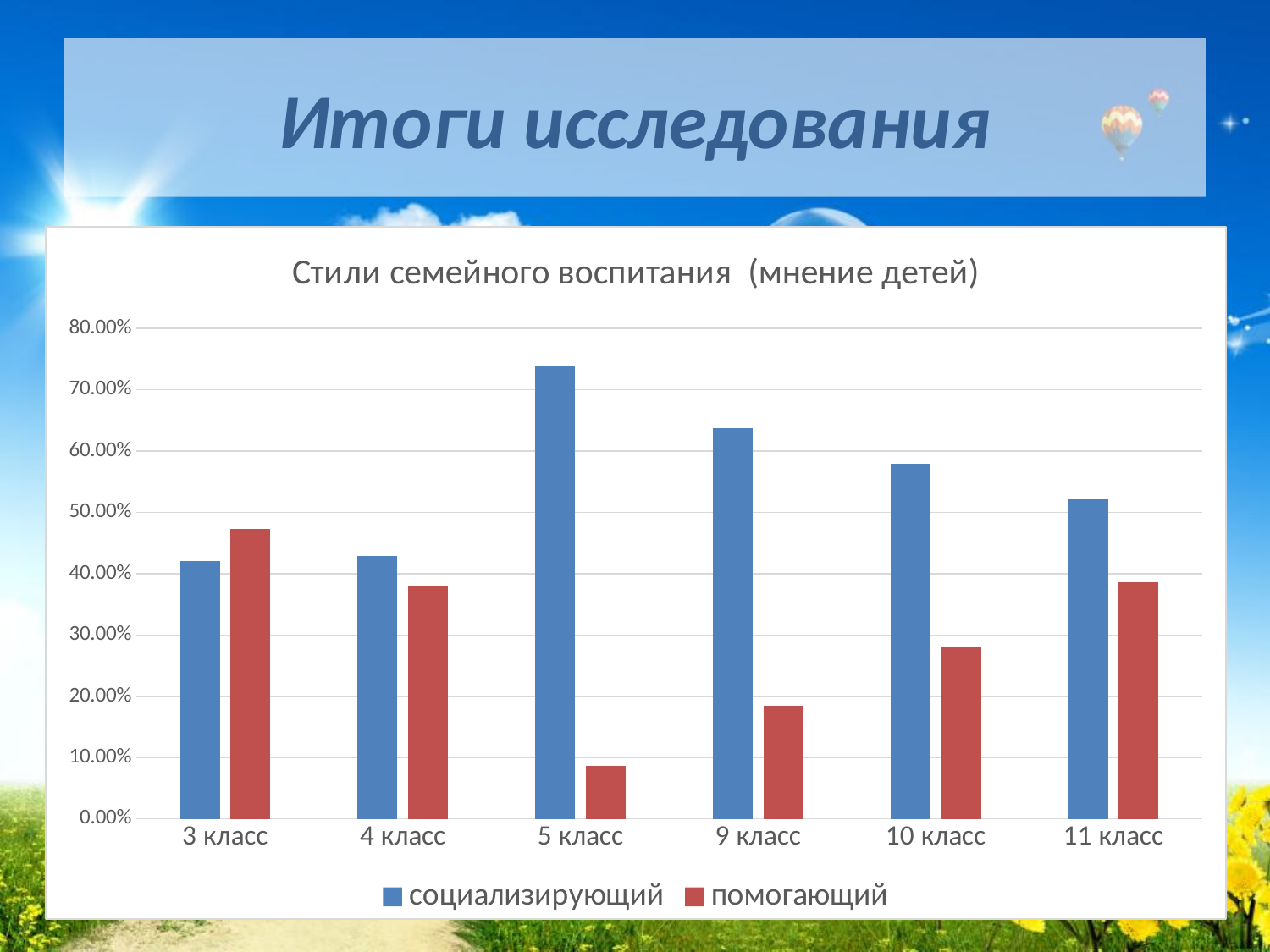
Which class has the highest value for the series 'помогающий'? 3 класс What kind of chart is shown on the slide? bar chart Which class has the highest value for the series 'социализирующий'? 5 класс Which class has the lowest value for the series 'помогающий'? 5 класс Do the values for 'социализирующий' rise or fall from 5 класс to 11 класс? fall Is the value for 'социализирующий' in 5 класс greater or less than 70.00%? greater How many series does the legend list? 2 How many classes (categories) are shown on the x axis? 6 Is the value for 'помогающий' in 10 класс greater or less than 30.00%? less In 3 класс, which series has the larger value: 'социализирующий' or 'помогающий'? помогающий What is the title of the chart? Стили семейного воспитания (мнение детей) Is the value for 'помогающий' in 5 класс greater or less than 10.00%? less